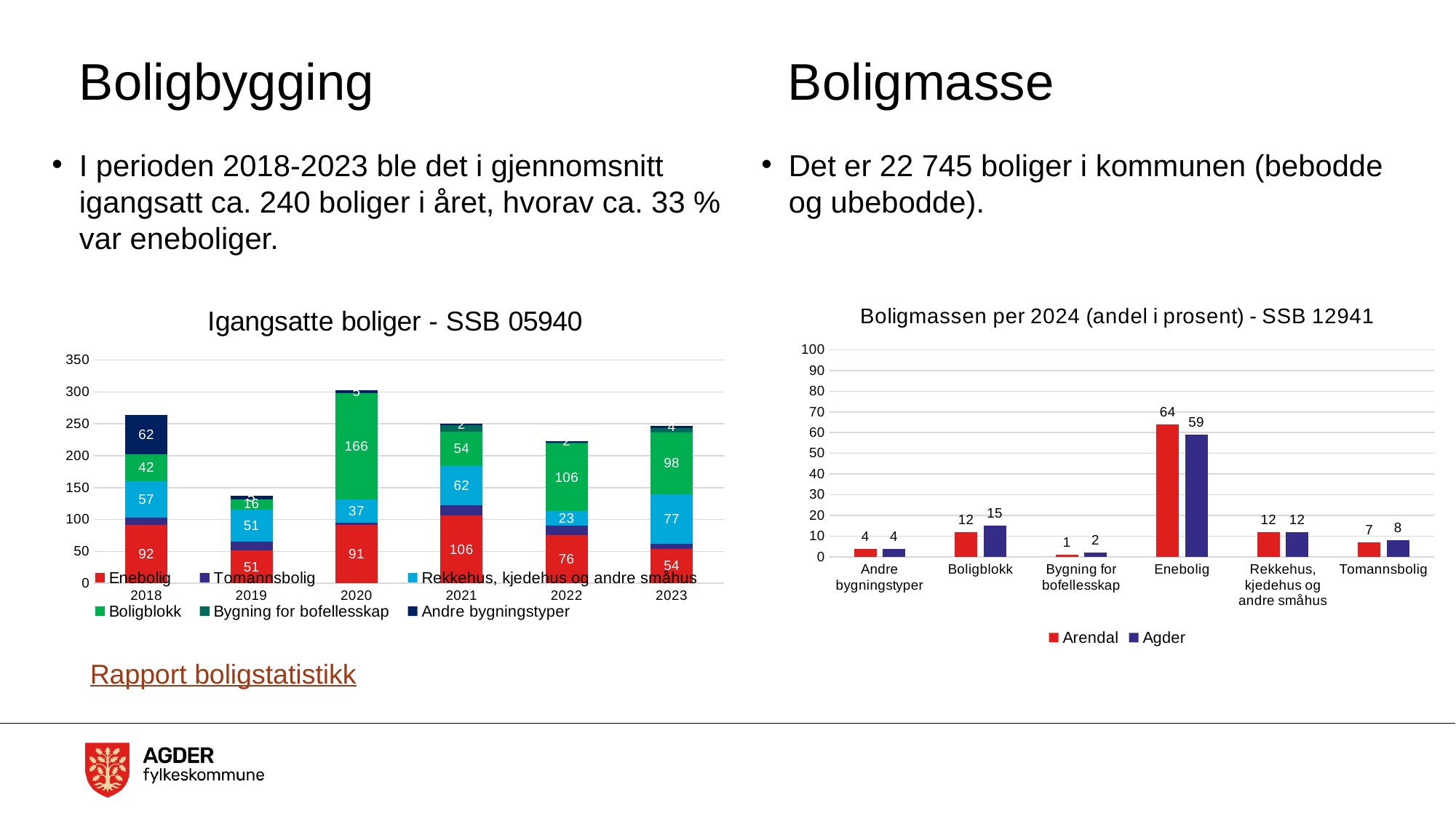
In the 'Igangsatte boliger - SSB 05940' chart, what is the value for Enebolig in 2021? 106 In the 'Igangsatte boliger - SSB 05940' chart, which year has the highest total stacked bar? 2020 In the 'Boligmassen per 2024 (andel i prosent) - SSB 12941' chart, what is the value for Arendal in the Enebolig category? 64 In the 'Igangsatte boliger - SSB 05940' chart, what is the value for Boligblokk in 2020? 166 In the 'Igangsatte boliger - SSB 05940' chart, what is the difference between the Enebolig values for 2018 and 2023? 38 In the 'Boligmassen per 2024 (andel i prosent) - SSB 12941' chart, what is the value for Agder in the Boligblokk category? 15 In the 'Igangsatte boliger - SSB 05940' chart, what is the value for Rekkehus, kjedehus og andre småhus in 2023? 77 What kind of chart is the 'Boligmassen per 2024 (andel i prosent) - SSB 12941' chart? Bar chart In the 'Igangsatte boliger - SSB 05940' chart, how many series does the legend list? 6 In the 'Boligmassen per 2024 (andel i prosent) - SSB 12941' chart, which category has the highest value for Arendal? Enebolig In the 'Boligmassen per 2024 (andel i prosent) - SSB 12941' chart, what is the difference between Arendal and Agder for Enebolig? 5 In the 'Igangsatte boliger - SSB 05940' chart, which year has the lowest total stacked bar? 2019